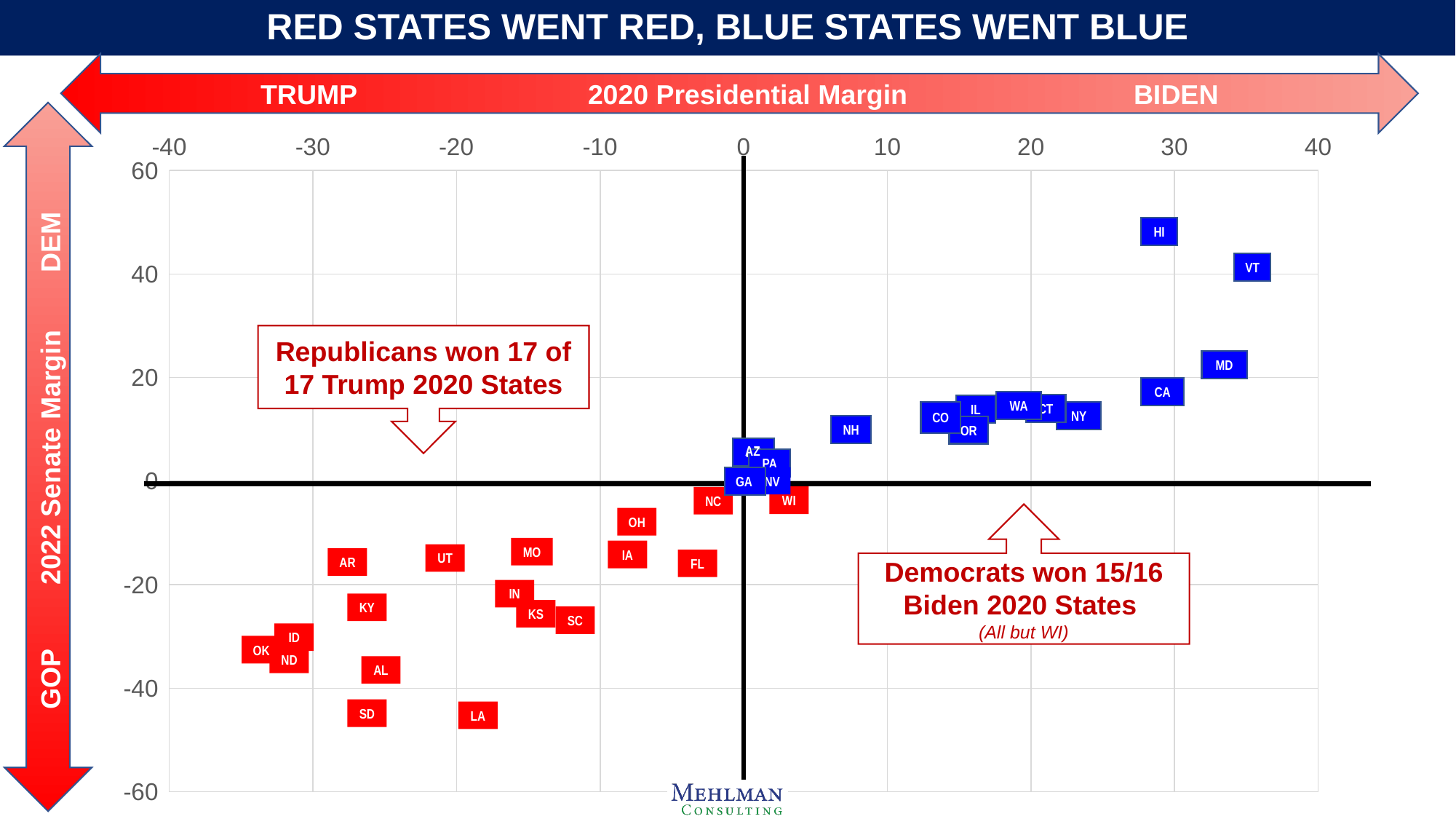
Which state has the higher 2022 Senate margin, CA or MD? MD Is the 2020 Presidential margin for NH greater or less than 10? less Is the 2022 Senate margin for LA greater or less than -40? less Is the 2022 Senate margin for AL greater or less than -30? less Which state has the higher 2022 Senate margin, HI or VT? HI What is the title of the chart? RED STATES WENT RED, BLUE STATES WENT BLUE What does the horizontal axis of the chart represent? 2020 Presidential Margin What kind of chart is shown on the slide? Scatter chart Which state has the highest 2022 Senate margin on the chart? HI